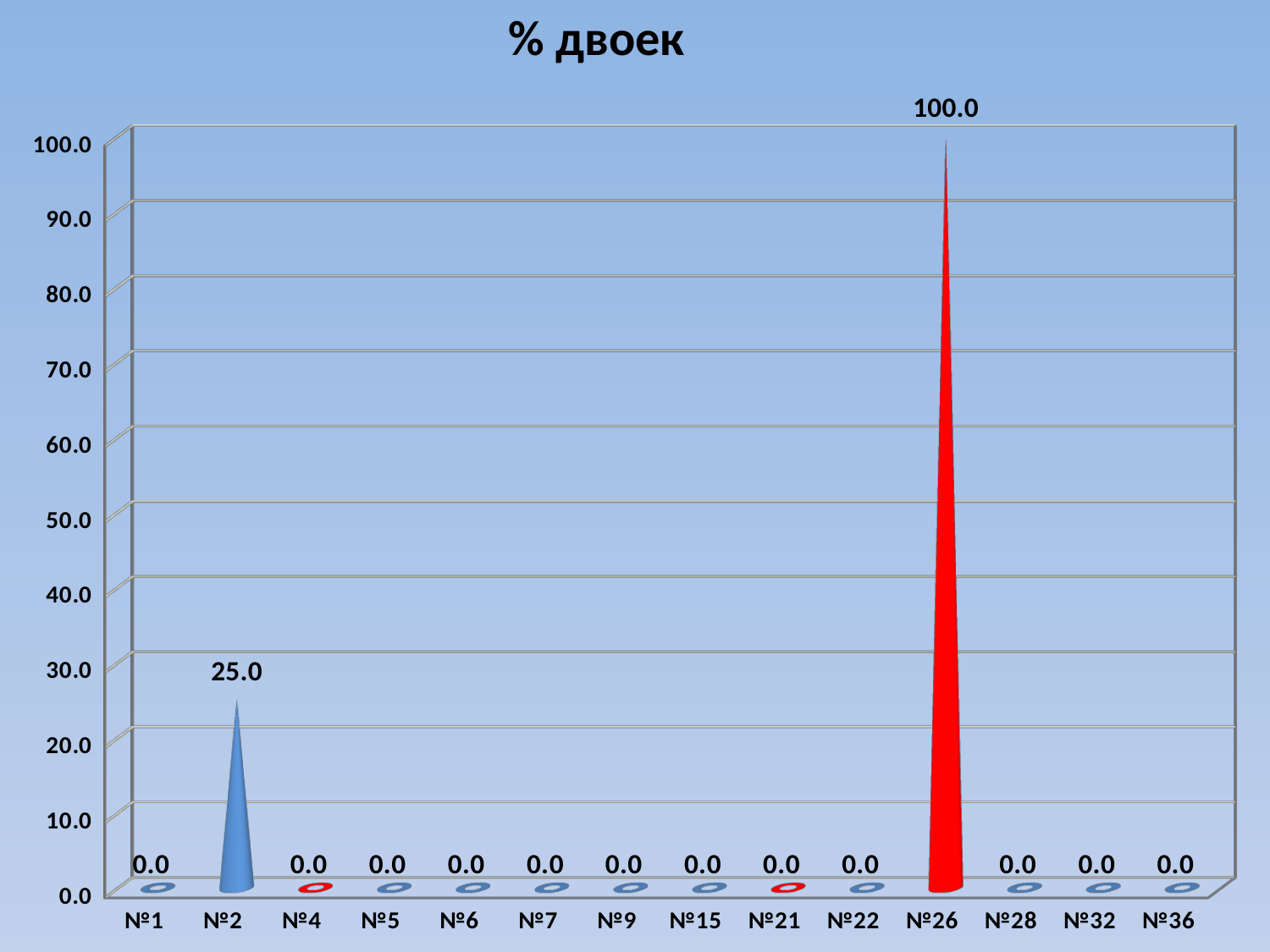
How many categories have a value of 0.0? 12 What kind of chart is this? bar chart What is the value for №26? 100.0 What colour is the bar for №26? red How many categories are shown on the x axis? 14 What is the title of the chart? % двоек Which is larger, the value for №2 or the value for №22? №2 What is the value for №2? 25.0 Which category has the highest value? №26 Is the value for №2 greater or less than 30.0? less What is the difference between the values for №26 and №2? 75.0 What is the value for №15? 0.0